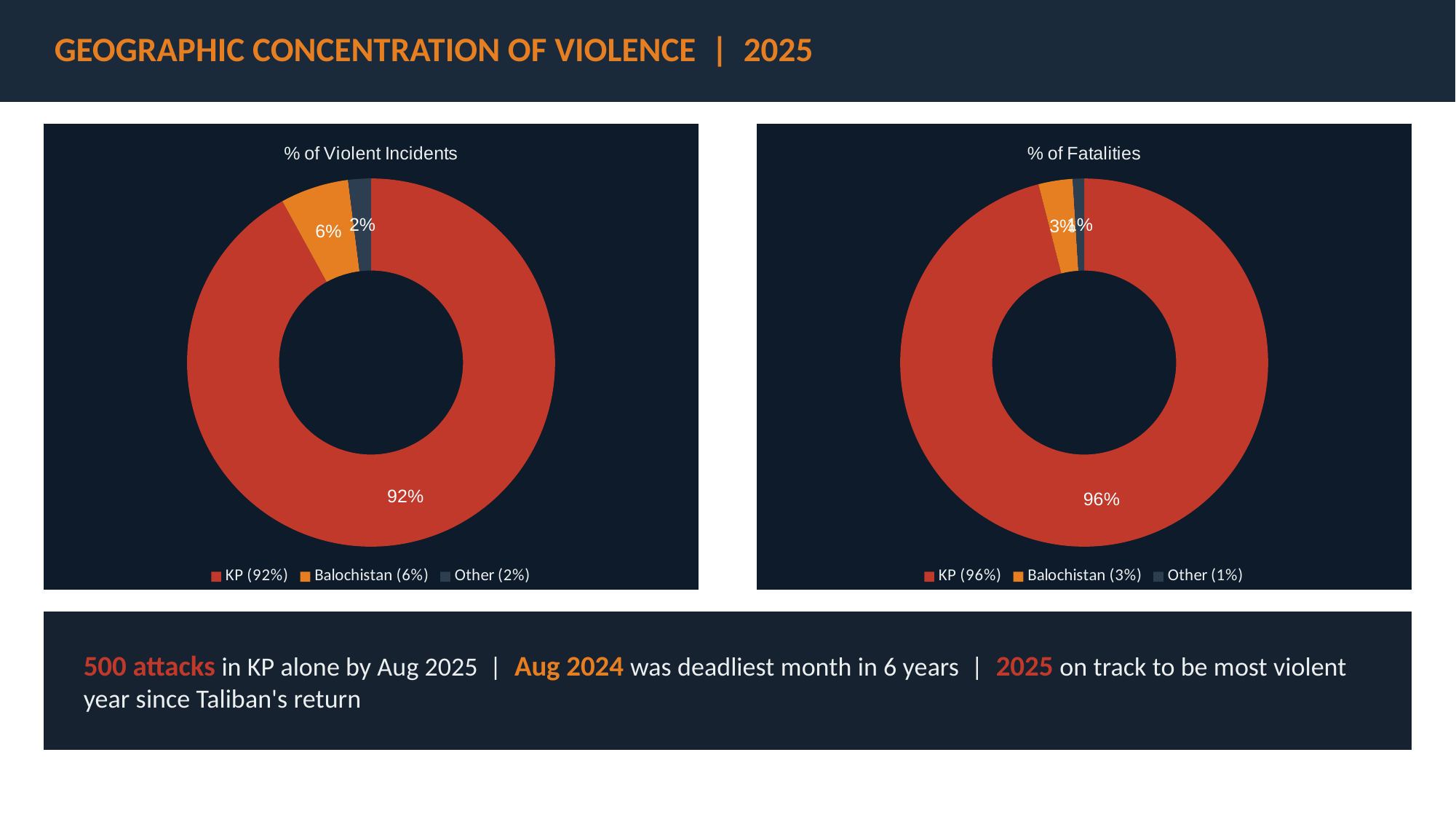
In the '% of Violent Incidents' chart, what is the value for Other? 2% In the '% of Violent Incidents' chart, what is the value for Balochistan? 6% In the '% of Violent Incidents' chart, which category has the smallest slice? Other In the '% of Fatalities' chart, what share of fatalities is attributed to KP? 96% What type of chart is the '% of Violent Incidents' chart? Doughnut (pie) chart In the '% of Fatalities' chart, what is the value for Balochistan? 3% In the '% of Violent Incidents' chart, what share of violent incidents is attributed to KP? 92% In the '% of Violent Incidents' chart, what is the difference between the KP and Balochistan shares? 86% In the '% of Fatalities' chart, which category has the largest slice? KP How many categories does the '% of Fatalities' chart show? 3 In the '% of Fatalities' chart, what is the value for Other? 1% Is KP's share larger in the '% of Violent Incidents' chart or the '% of Fatalities' chart? % of Fatalities